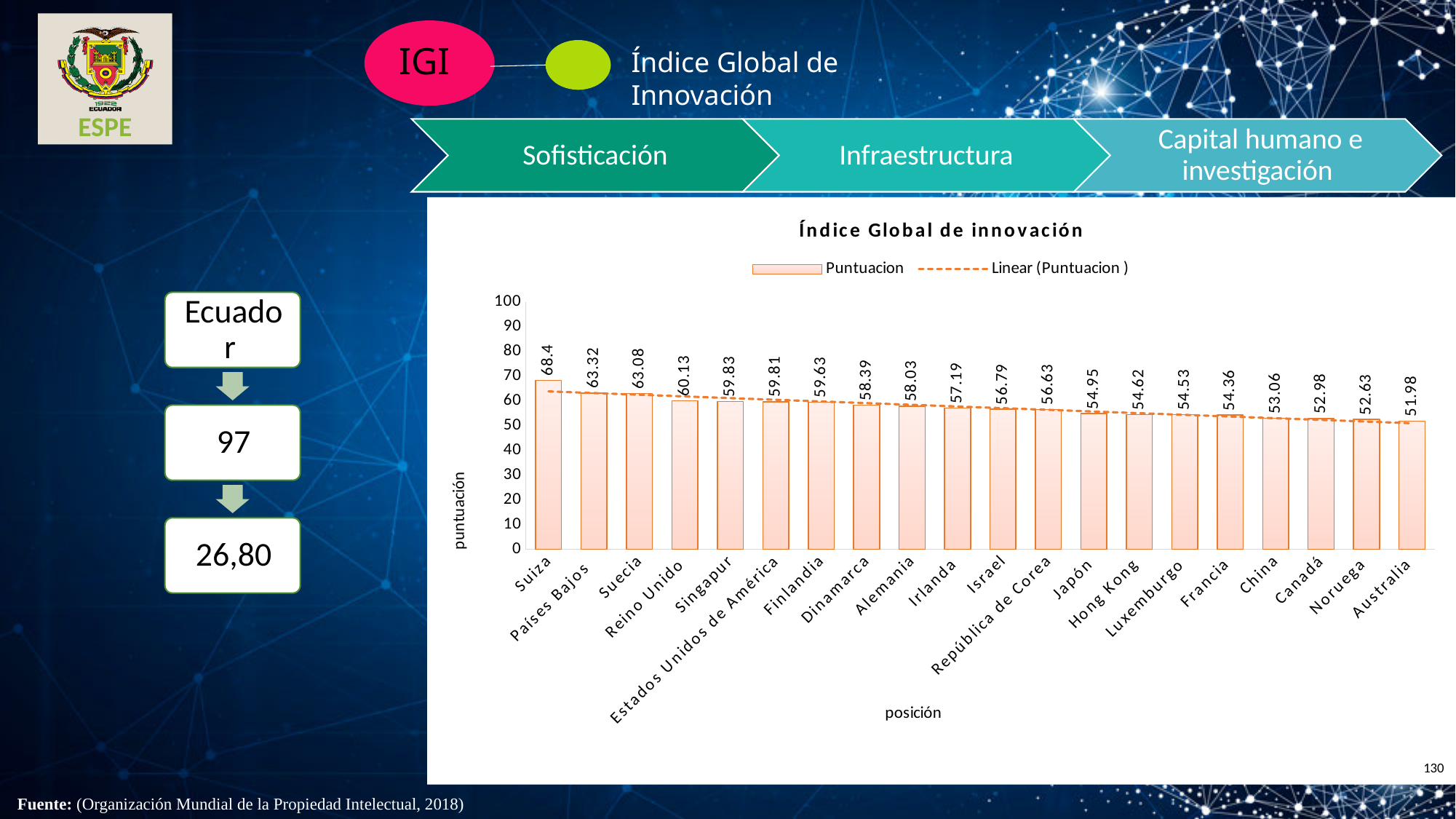
What kind of chart is shown on the slide? Bar chart How many countries are shown on the x axis of the chart? 20 What is the value for Estados Unidos de América in the chart? 59.81 How many entries does the chart legend list? 2 Which country has the lowest value in the chart? Australia What is the value for Japón in the chart? 54.95 What is the difference between the values for Suiza and Australia? 16.42 What is the value for Suiza in the Índice Global de innovación chart? 68.4 Do the values rise or fall from left to right along the x axis? Fall Which country has the highest value in the chart? Suiza What is the difference between the values for Suiza and Países Bajos? 5.08 Which has a larger value, Reino Unido or China? Reino Unido